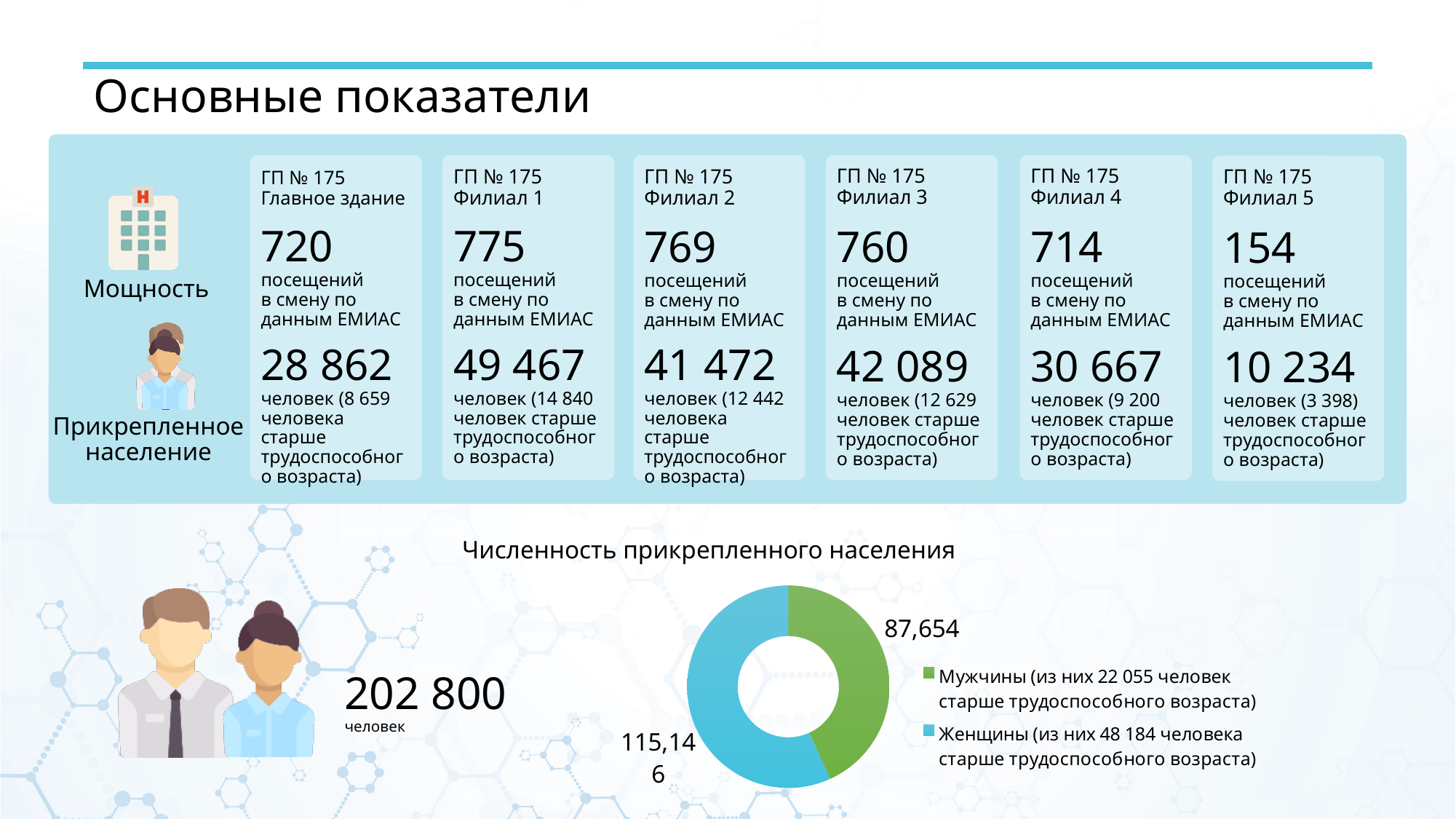
In the chart "Численность прикрепленного населения", which category has the smaller value? Мужчины What kind of chart is shown under the title "Численность прикрепленного населения"? donut (pie) chart In the chart "Численность прикрепленного населения", what is the value for Женщины? 115,146 In the chart "Численность прикрепленного населения", what share of the total does the Мужчины slice represent? 43.2% How many slices does the chart "Численность прикрепленного населения" have? 2 In the chart "Численность прикрепленного населения", what colour is the Мужчины slice? green In the chart "Численность прикрепленного населения", what is the value for Мужчины? 87,654 In the chart "Численность прикрепленного населения", what is the difference between the values for Женщины and Мужчины? 27,492 In the chart "Численность прикрепленного населения", is the value for Женщины larger or smaller than the value for Мужчины? larger What is the title of the chart on the slide? Численность прикрепленного населения In the chart "Численность прикрепленного населения", what is the total of the two slices? 202,800 In the chart "Численность прикрепленного населения", which category has the larger value? Женщины